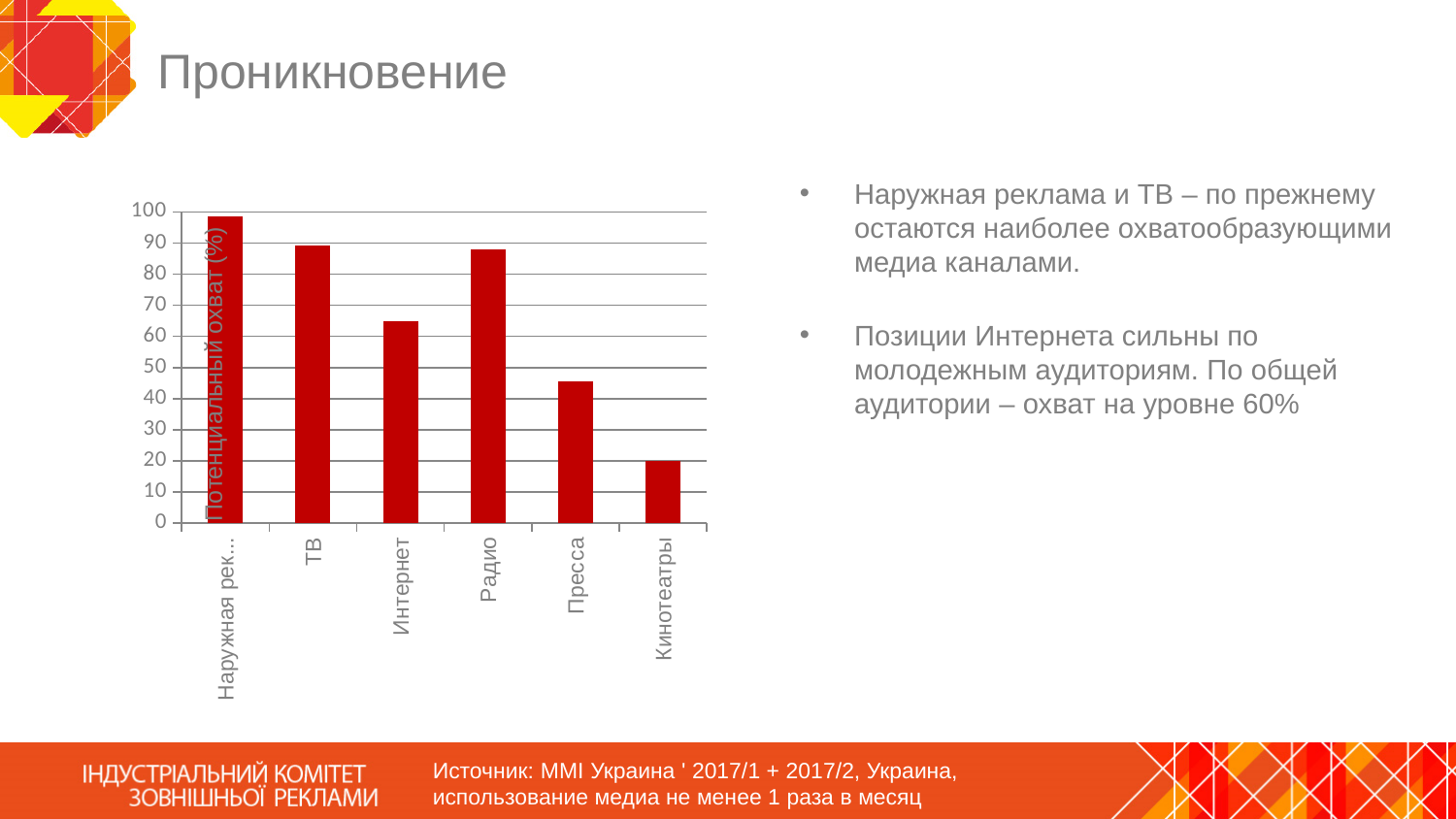
Is the value for Пресса greater or less than 50? less Which is larger, the value for Интернет or the value for Пресса? Интернет Which category has the lowest bar in the chart? Кинотеатры What kind of chart is shown on the slide? bar chart How many categories are shown on the x axis of the chart? 6 Is the value for Интернет greater or less than 70? less Is the value for Радио greater or less than 80? greater Which category has the highest bar in the chart? Наружная реклама What is the label on the vertical axis of the chart? Потенциальный охват (%)